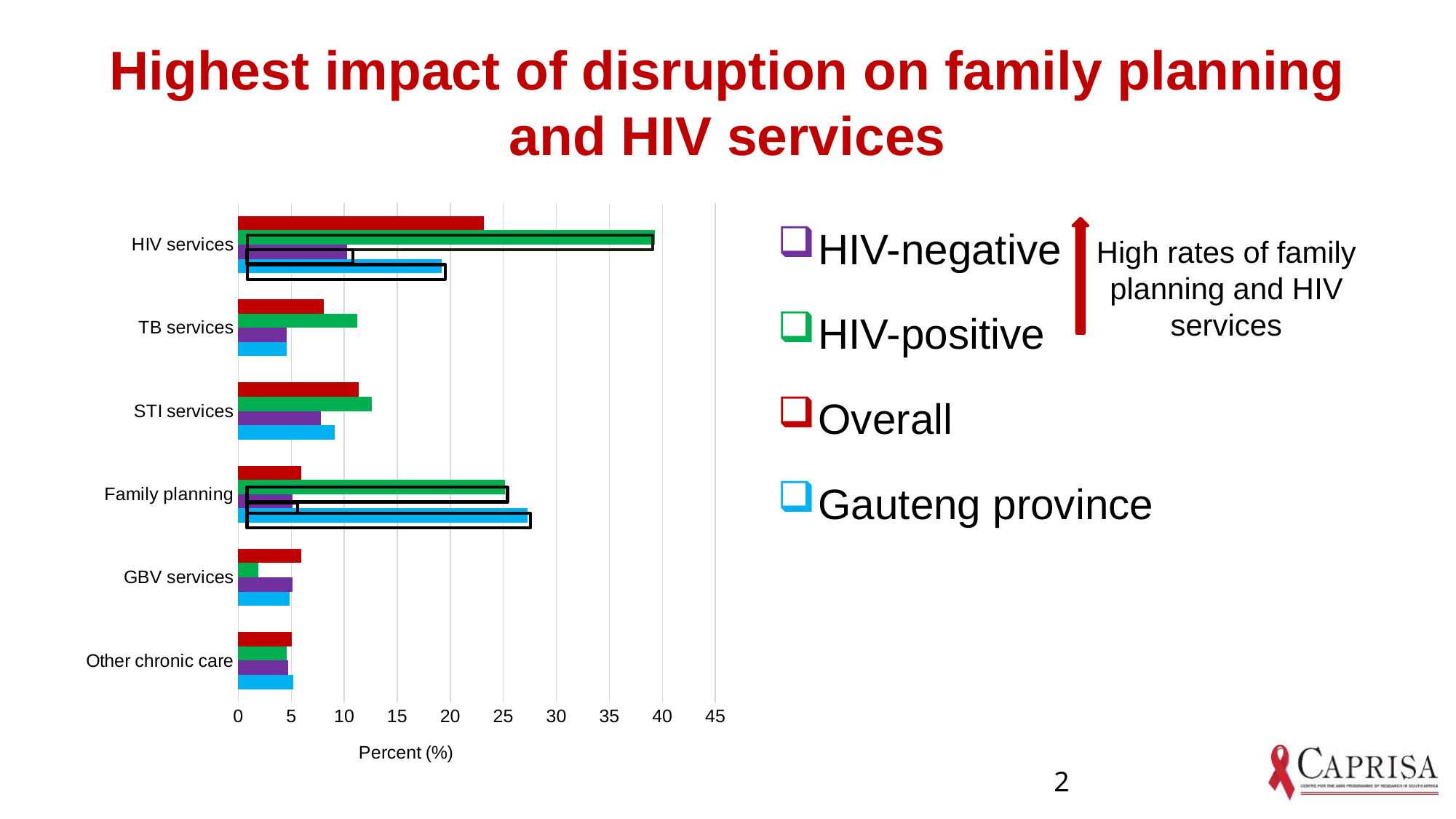
Which service category has the highest HIV-positive value? HIV services What is the label of the horizontal axis? Percent (%) For HIV services, which is larger: the HIV-positive value or the Overall value? HIV-positive How many series does the legend list? 4 Is the HIV-positive value for GBV services greater or less than 5? less Is the HIV-positive value for HIV services greater or less than 35? greater Which service category has the highest Gauteng province value? Family planning Which service category has the lowest HIV-positive value? GBV services Is the Overall value for HIV services greater or less than 20? greater How many service categories are shown on the chart? 6 What kind of chart is shown on the slide? Bar chart